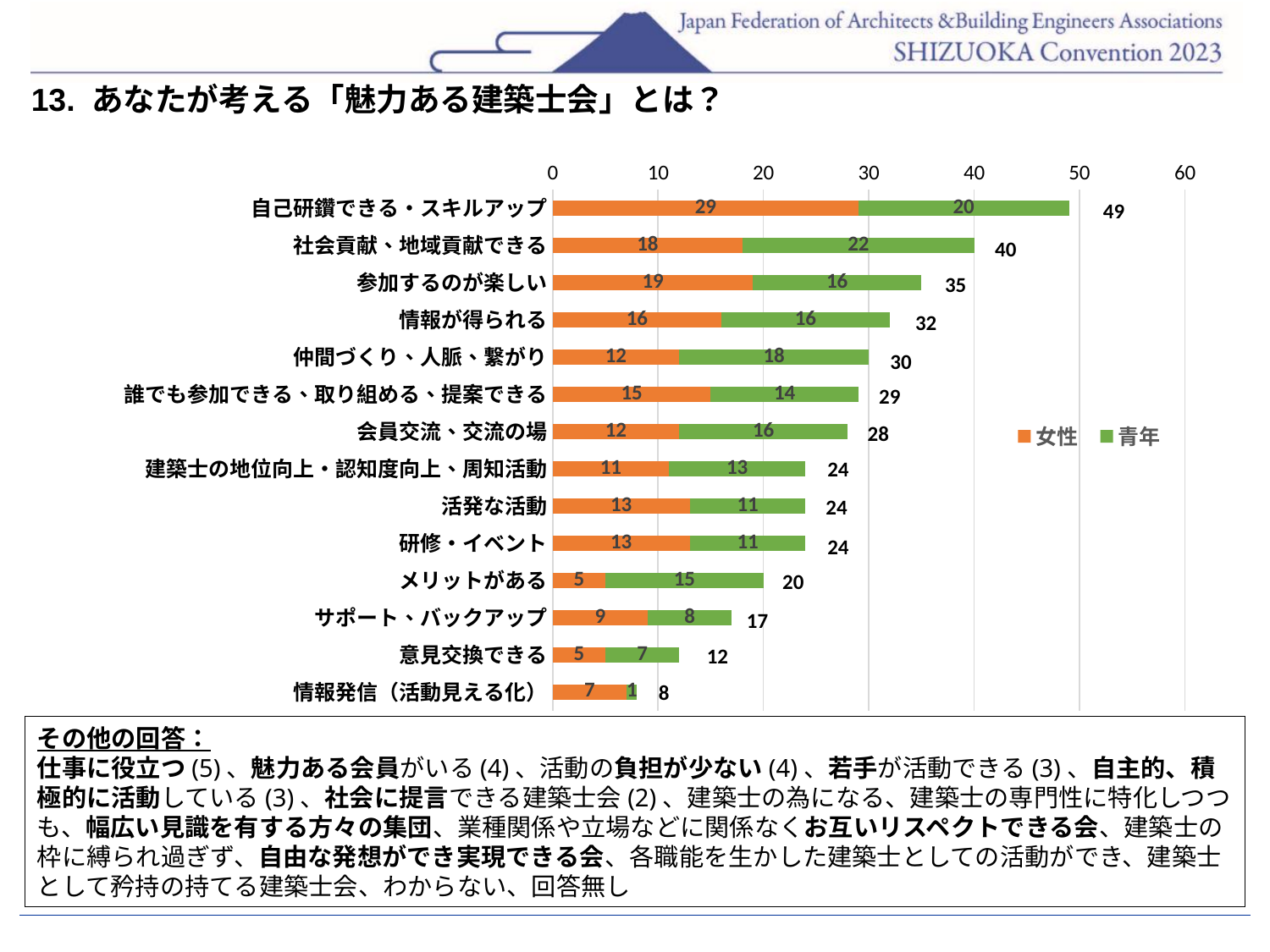
How many series does the legend list? 2 What type of chart is shown on the slide? Stacked bar chart What is the 青年 value for 社会貢献、地域貢献できる? 22 What is the difference between the 女性 and 青年 values for メリットがある? 10 Which category has the highest total? 自己研鑽できる・スキルアップ Which series is shown in orange in the legend? 女性 Which is larger for 仲間づくり、人脈、繋がり: the 女性 value or the 青年 value? 青年 How many categories are plotted in the chart? 14 What is the total of the stacked bar for 参加するのが楽しい? 35 Which category has the lowest total? 情報発信（活動見える化） What is the 女性 value for 自己研鑽できる・スキルアップ? 29 Is the total for 情報が得られる greater or less than 30? greater